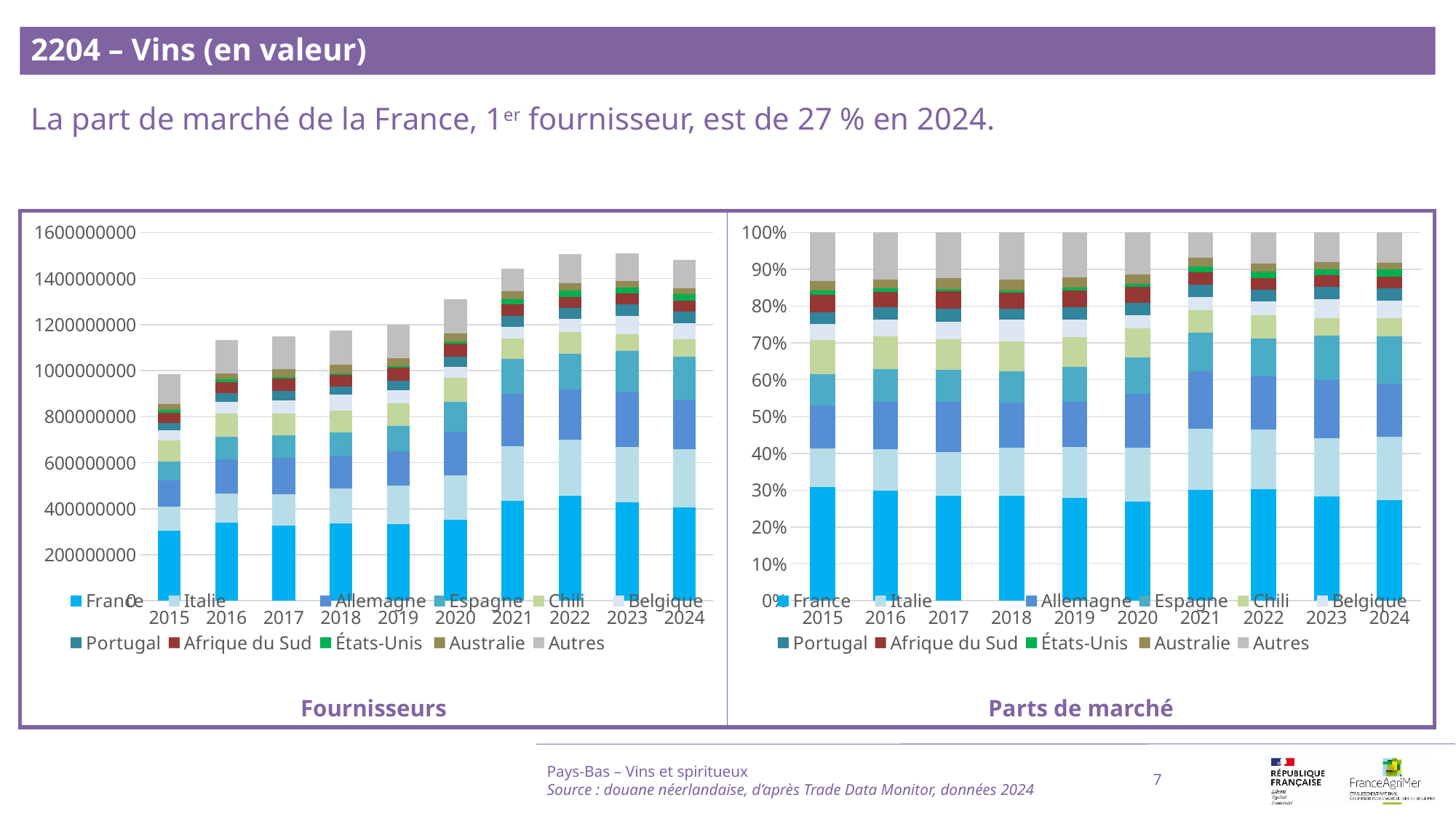
Which series is listed first in the legend of the 'Parts de marché' chart? France In the 'Parts de marché' chart, is the France share for 2020 greater or less than 30%? less In the 'Fournisseurs' chart, is the total bar for 2020 greater or less than 1200000000? greater In the 'Fournisseurs' chart, do the total bars generally rise or fall from 2015 to 2024? rise In the 'Fournisseurs' chart, is the total bar for 2024 greater or less than 1400000000? greater How many years are shown on the x axis of the 'Parts de marché' chart? 10 In the 'Fournisseurs' chart, which year has the lowest total bar? 2015 What kind of chart is the 'Fournisseurs' chart on the left? stacked bar chart How many series does the legend of the 'Fournisseurs' chart list? 11 In the 'Fournisseurs' chart, is the total bar for 2021 larger or smaller than the total bar for 2019? larger